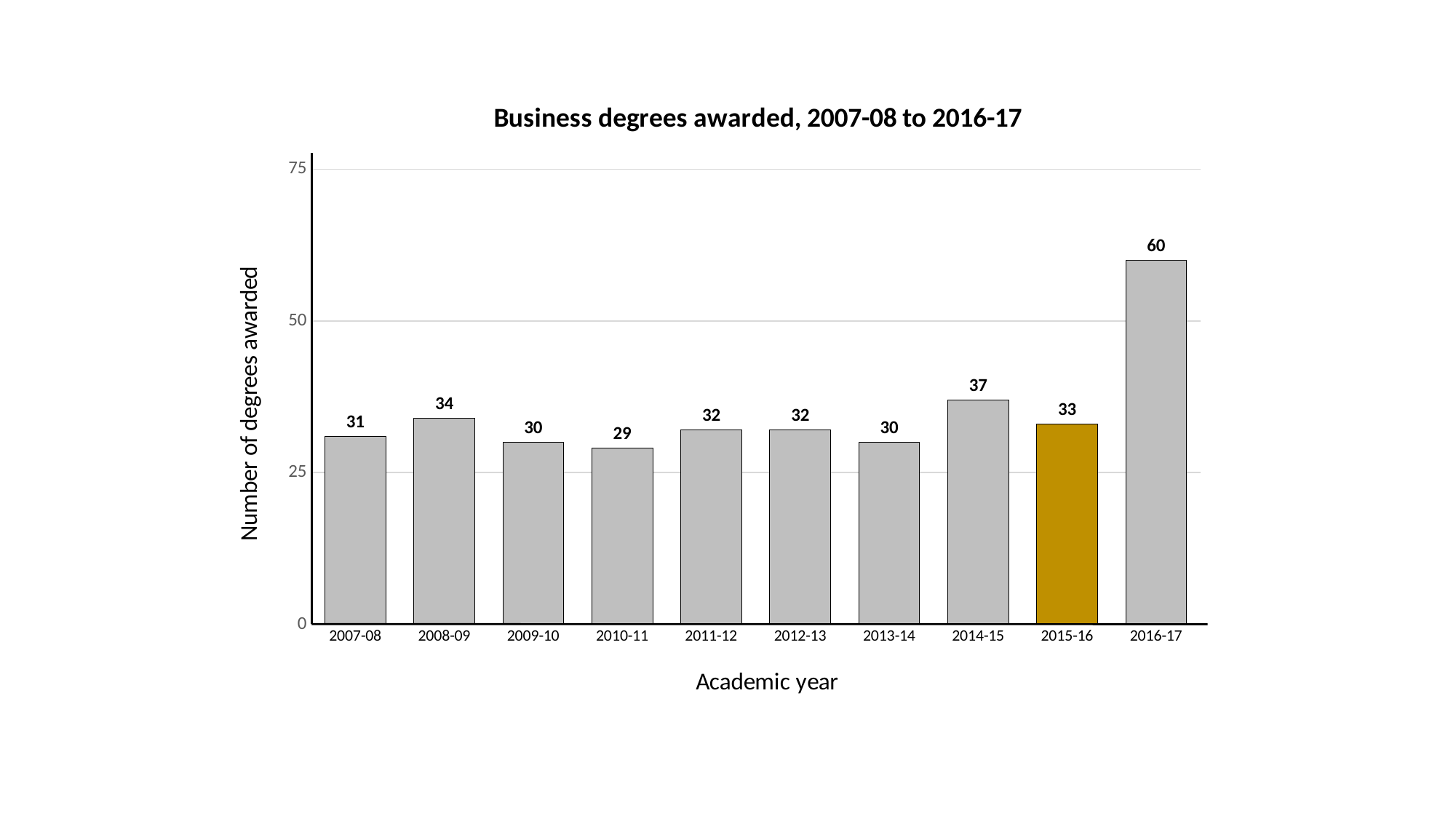
Which year had more degrees awarded, 2008-09 or 2014-15? 2014-15 Is the value for 2016-17 greater or less than 50? greater What is the difference between the number of degrees awarded in 2016-17 and 2015-16? 27 How many business degrees were awarded in 2015-16? 33 What is the value for 2010-11? 29 How many academic years are shown on the x axis? 10 What is the title of the chart? Business degrees awarded, 2007-08 to 2016-17 Which bar is highlighted in a different colour (gold) from the others? 2015-16 Which academic year had the highest number of degrees awarded? 2016-17 Which academic year had the lowest number of degrees awarded? 2010-11 What kind of chart is shown on the slide? bar chart What is the difference between the values for 2014-15 and 2013-14? 7